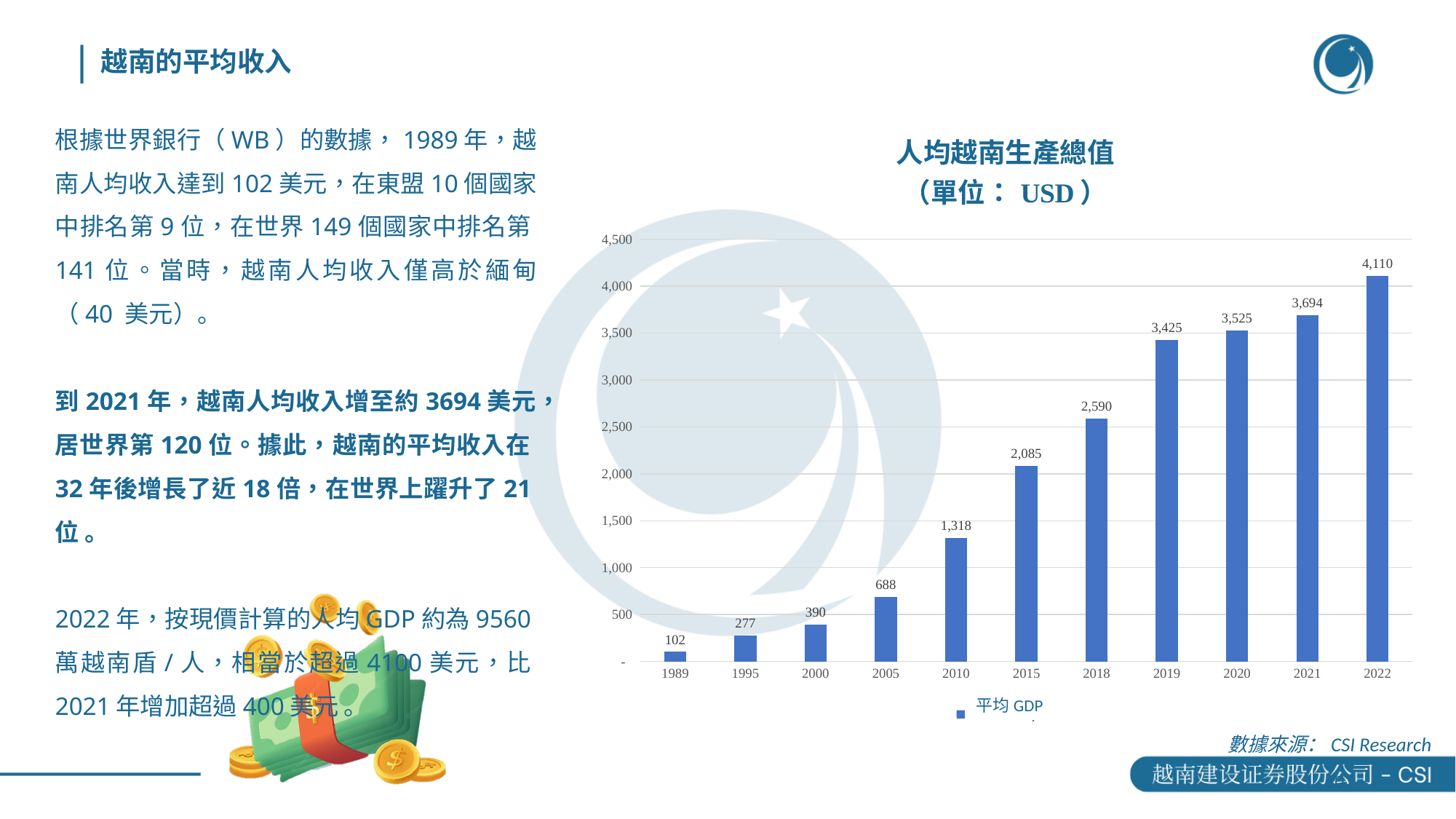
Which year has the highest value in the chart? 2022 Which year has the lowest value in the chart? 1989 What is the value for 2010 in the chart? 1,318 What is the difference between the values for 2022 and 2021? 416 How many years are shown on the x axis of the chart? 11 How many series does the chart legend list? 1 What is the value for 2019 in the chart? 3,425 What is the difference between the values for 2018 and 2015? 505 Is the value for 2020 greater or less than 3,000? greater Which is larger, the value for 2005 or the value for 2000? 2005 Do the values rise or fall from 1989 to 2022? rise What kind of chart is shown on the slide? bar chart